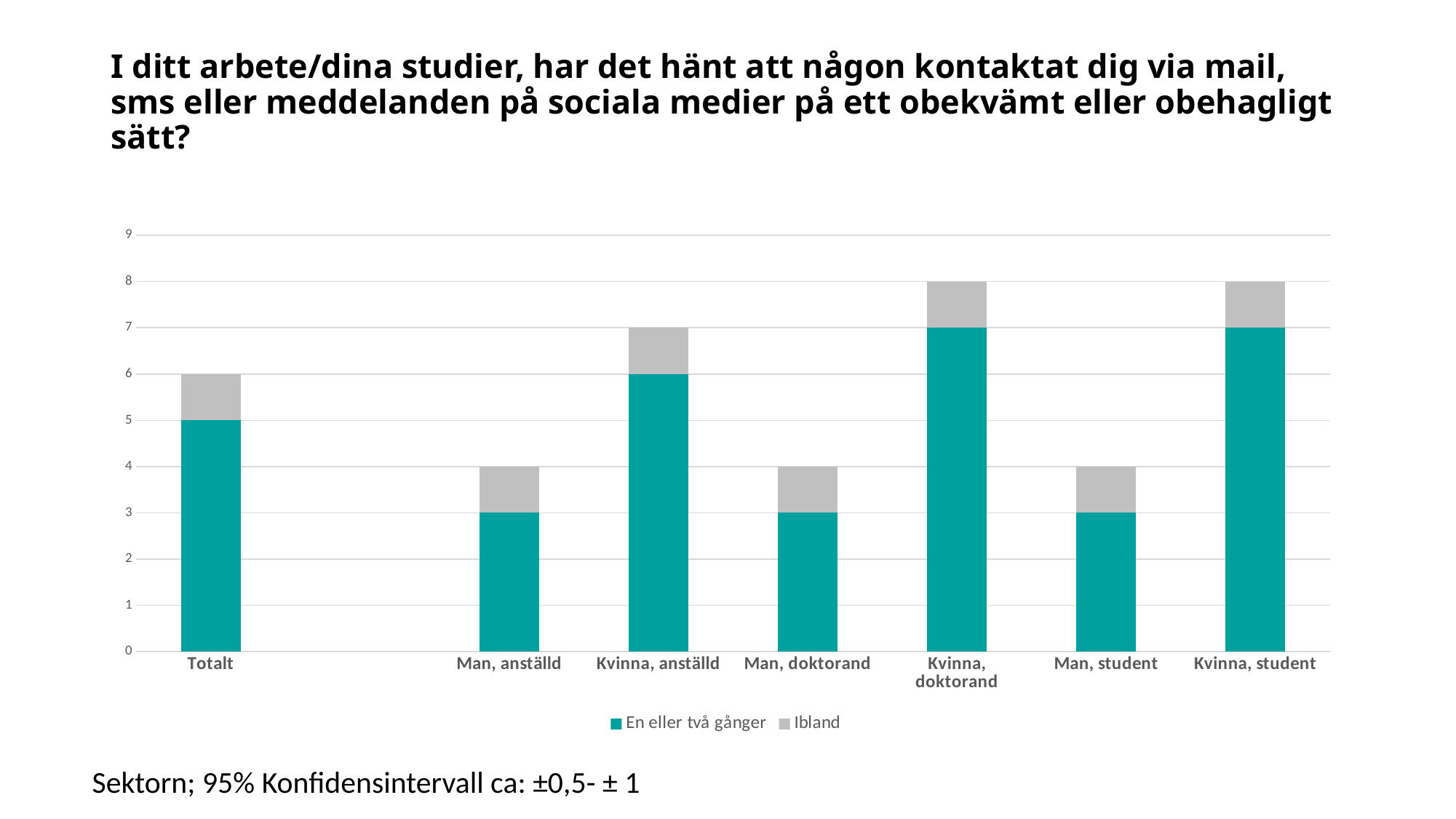
Which is larger, the total bar for Kvinna, anställd or the total bar for Man, anställd? Kvinna, anställd Which series is shown in grey in the legend? Ibland What is the total height of the stacked bar for Totalt? 6 What is the difference between the "En eller två gånger" values for Kvinna, anställd and Man, doktorand? 3 How many categories are shown on the x axis? 7 What kind of chart is shown on the slide? Stacked bar chart What is the value of "En eller två gånger" for Kvinna, doktorand? 7 Is the total bar for Man, student greater or less than 5? less What is the value of "En eller två gånger" for Totalt? 5 What is the value of "En eller två gånger" for Man, anställd? 3 How many series does the legend list? 2 What is the total height of the stacked bar for Kvinna, student? 8